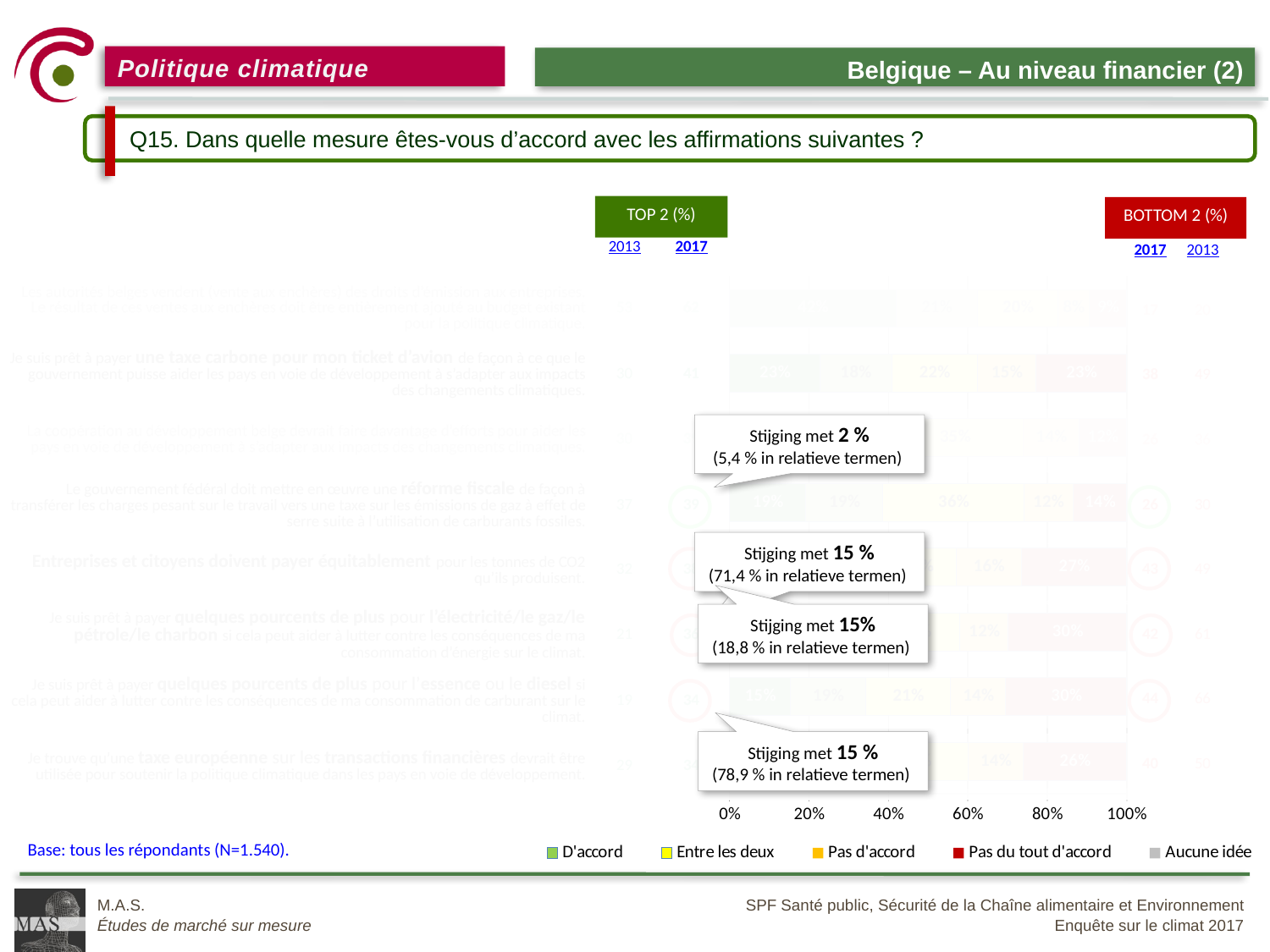
What is the first entry in the chart legend? D'accord What is the last entry in the chart legend? Aucune idée How many series does the legend list? 5 In the callout that mentions '18,8 % in relatieve termen', what is the absolute increase stated? 15% What kind of chart is shown on the slide? bar chart In the callout that mentions '78,9 % in relatieve termen', what is the absolute increase stated? 15 % Which two years are compared in the TOP 2 (%) columns? 2013 and 2017 How many callout boxes on the chart state an increase of 15 %? 3 What is the highest tick value shown on the horizontal axis? 100% According to the callout reading 'Stijging met 2 %', what is the increase in relative terms? 5,4 %